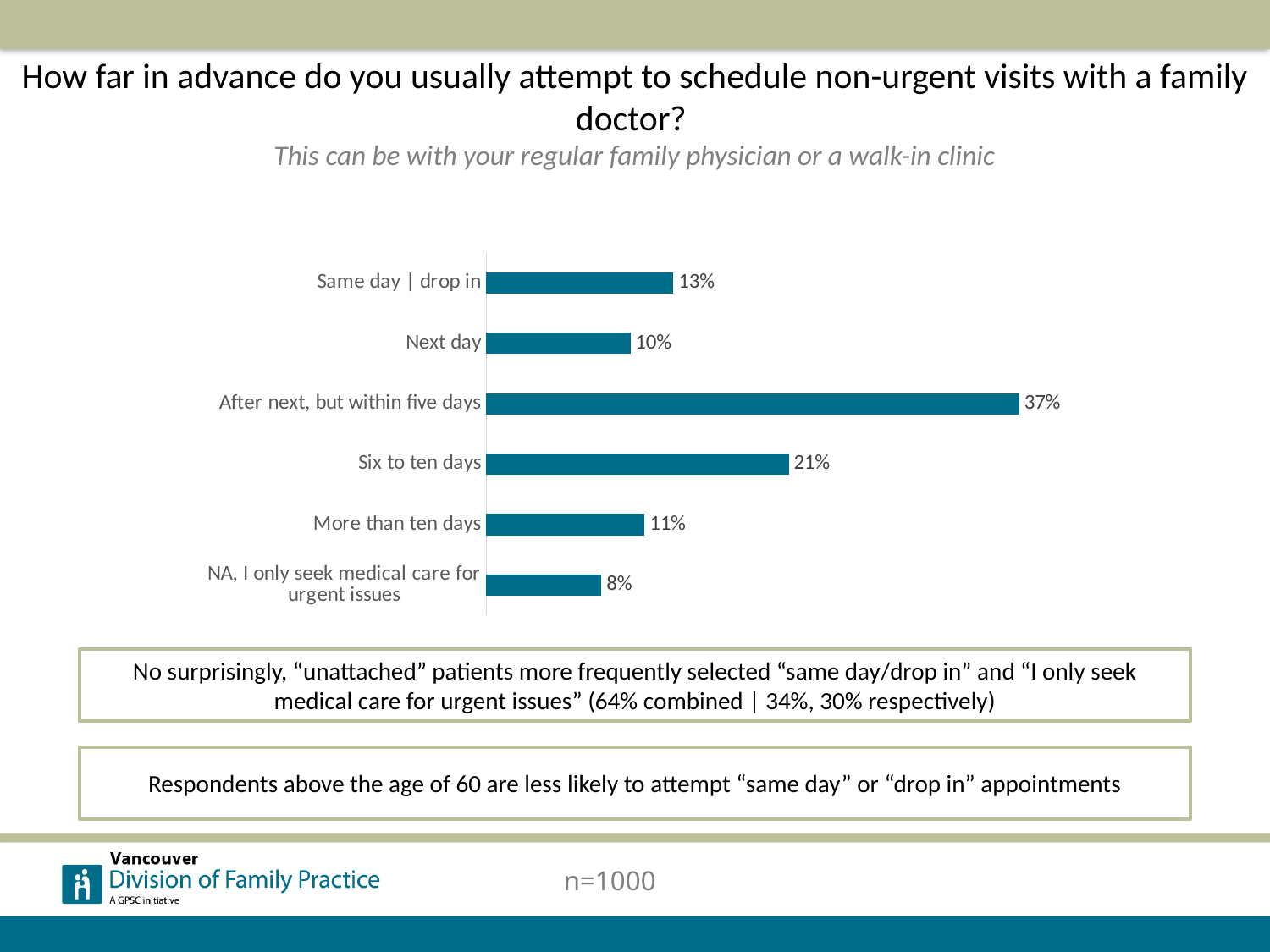
What type of chart is shown on the slide? Bar chart What is the difference in percentage points between "After next, but within five days" and "Six to ten days"? 16 Which is larger, the value for "More than ten days" or the value for "Next day"? More than ten days What percentage of respondents selected "Same day | drop in"? 13% What percentage of respondents selected "NA, I only seek medical care for urgent issues"? 8% What percentage of respondents selected "After next, but within five days"? 37% Which category has the highest percentage? After next, but within five days Which category has the lowest percentage? NA, I only seek medical care for urgent issues What is the sample size (n) stated on the slide? n=1000 What is the difference in percentage points between "Same day | drop in" and "Next day"? 3 What percentage of respondents selected "Six to ten days"? 21% How many categories are shown in the chart? 6